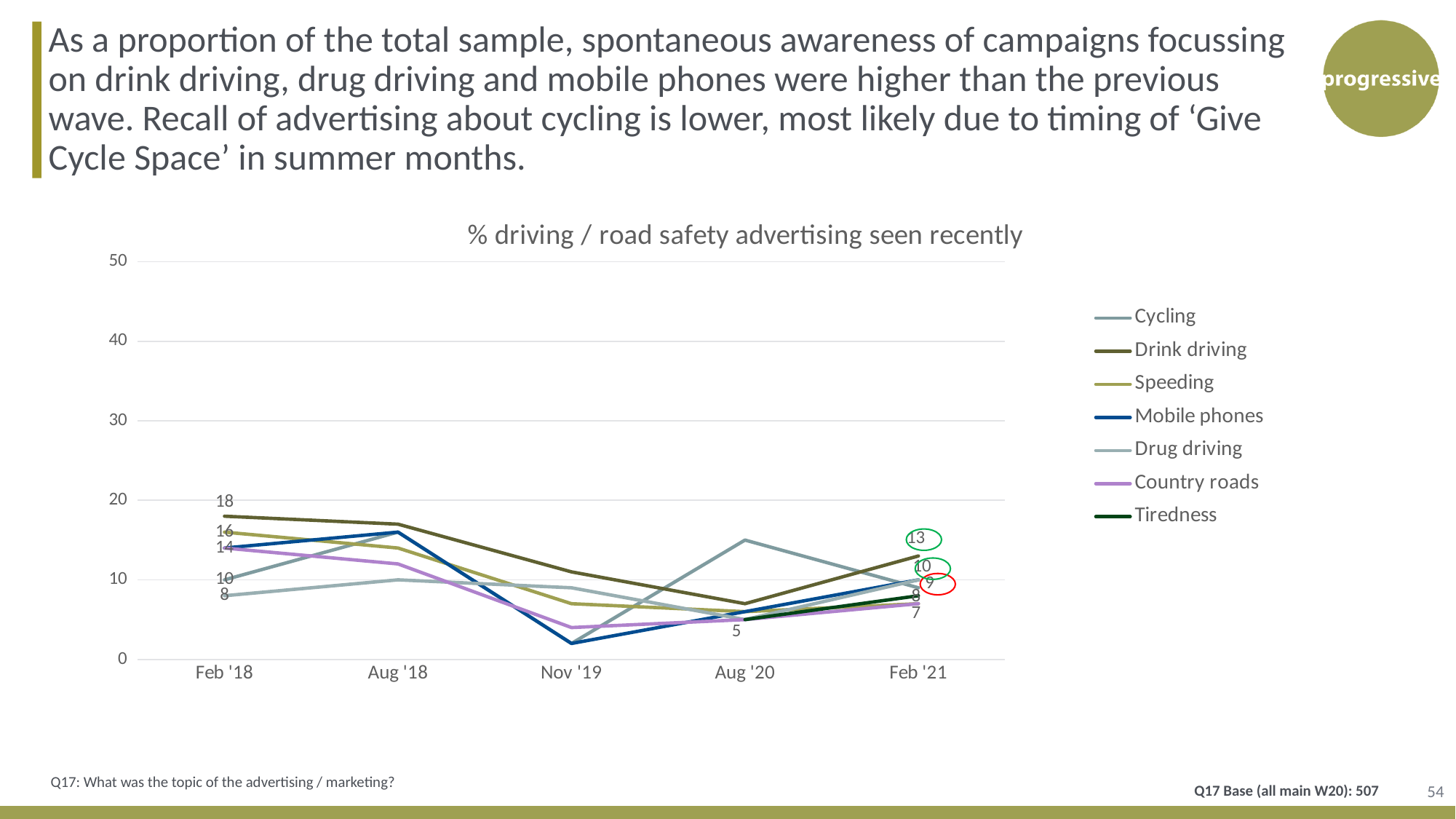
How many time points are shown on the x axis? 5 What is the difference between the Drink driving values in Feb '18 and Feb '21? 5 What is the title of the chart? % driving / road safety advertising seen recently What is the value for Cycling in Feb '21? 9 How many series does the legend list? 7 What kind of chart is shown on the slide? line chart What is the value for Drink driving in Feb '18? 18 Which series has the highest value in Feb '21? Drink driving Is the value for Mobile phones in Nov '19 greater or less than 10? less Does the Drink driving line rise or fall from Feb '18 to Aug '20? fall Is the value for Cycling in Aug '20 greater or less than 10? greater What is the value for Drink driving in Feb '21? 13